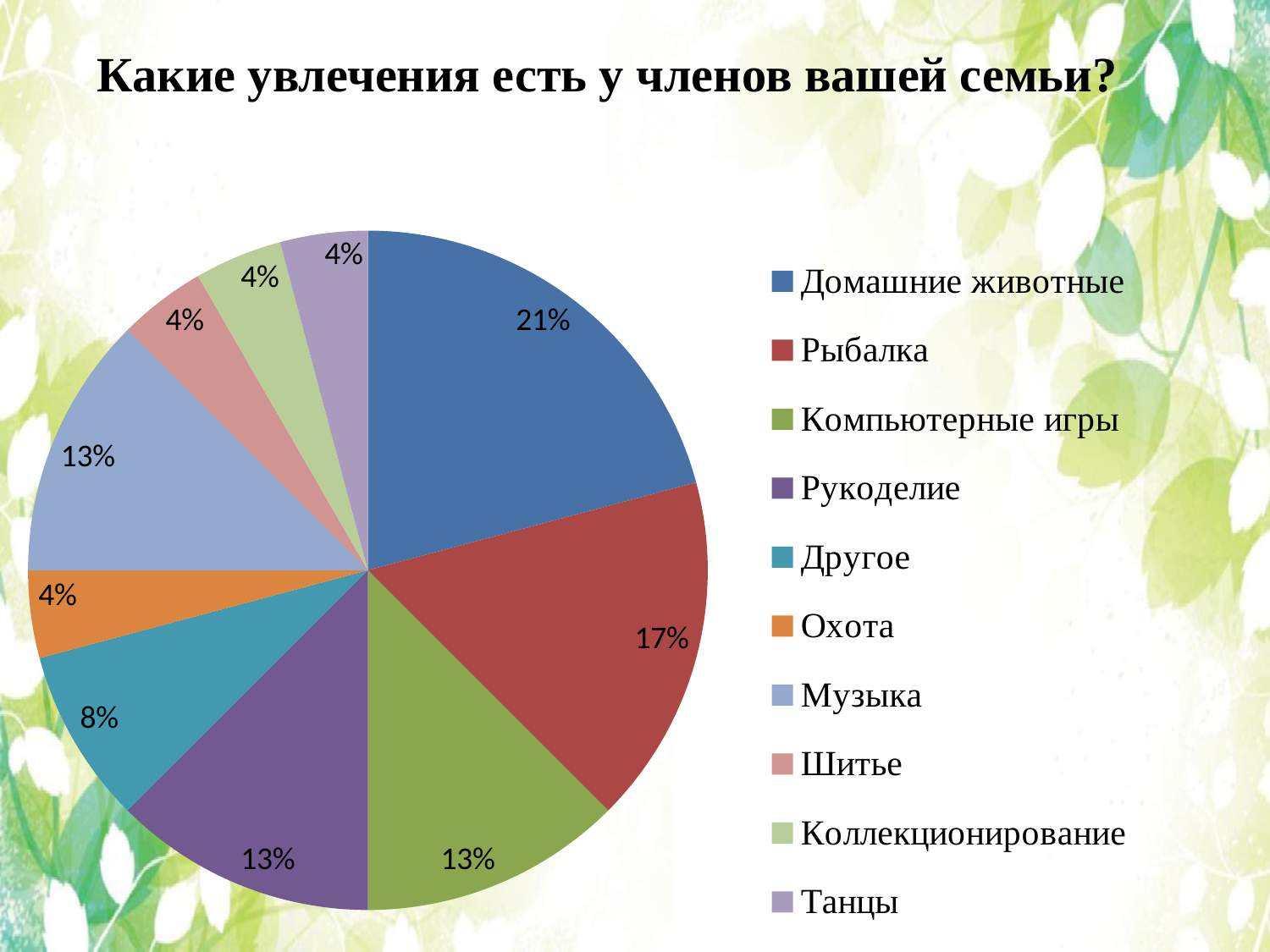
What is the value for Другое? 8% How many categories are shown in the pie chart? 10 What is the value for Музыка? 13% Which is larger, the value for Рыбалка or the value for Рукоделие? Рыбалка What is the value for Охота? 4% What is the title of the chart? Какие увлечения есть у членов вашей семьи? What is the value for Рыбалка? 17% What type of chart is shown on the slide? pie chart Which category has the largest slice of the pie? Домашние животные What is the difference between the values for Компьютерные игры and Другое? 5% What is the difference between the values for Домашние животные and Рыбалка? 4% What share of the pie does Домашние животные have? 21%